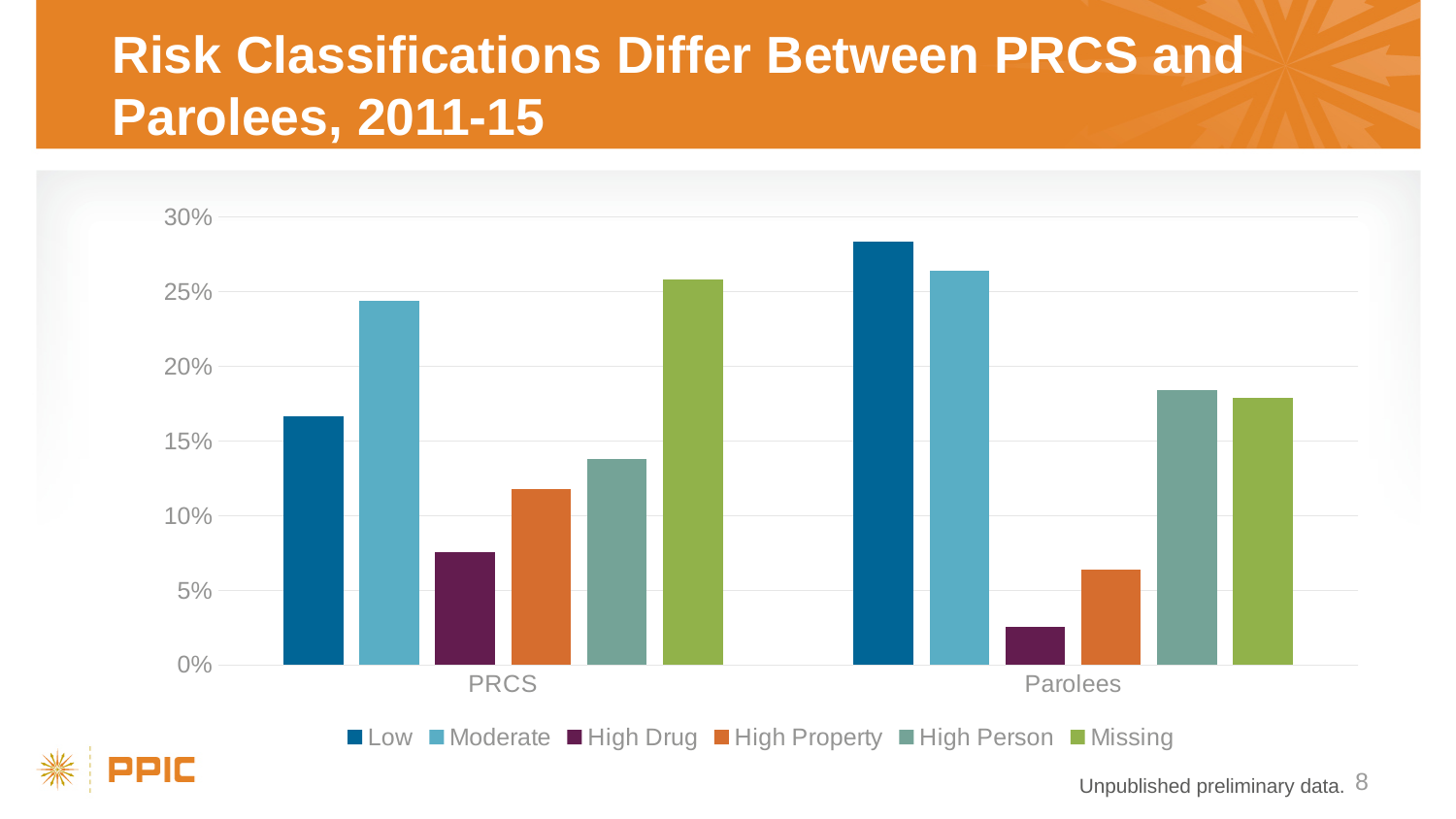
Which risk classification has the highest value for Parolees? Low Which is larger: the Low value for PRCS or the Low value for Parolees? Parolees How many series does the legend list? 6 Is the value for High Drug among Parolees greater or less than 5%? less Which risk classification has the lowest value for PRCS? High Drug Is the value for Low among Parolees greater or less than 25%? greater Which risk classification has the highest value for PRCS? Missing How many categories are shown on the x axis? 2 Which risk classification has the lowest value for Parolees? High Drug What kind of chart is shown on the slide? bar chart Is the value for Low among PRCS greater or less than 15%? greater What is the title of the chart? Risk Classifications Differ Between PRCS and Parolees, 2011-15